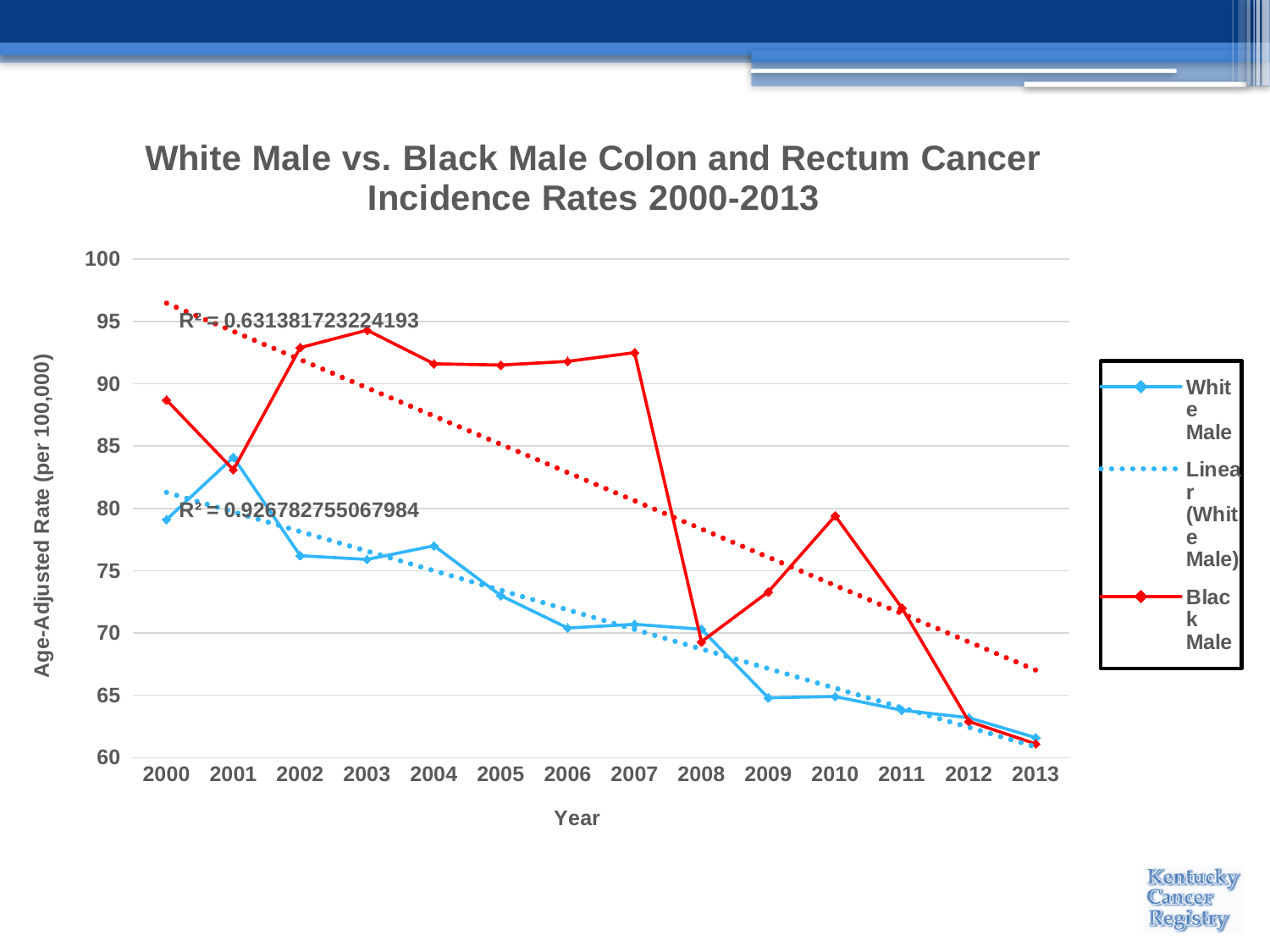
In 2009, which series has the higher value, White Male or Black Male? Black Male What is the title of the y axis? Age-Adjusted Rate (per 100,000) How many years are plotted along the x axis? 14 Is the White Male value for 2013 greater or less than 65? less How many entries does the legend list? 3 What kind of chart is shown on the slide? line chart What is the R² value shown for the White Male linear trendline? 0.926782755067984 In which year is the White Male incidence rate lowest? 2013 Does the White Male incidence rate generally rise or fall from 2000 to 2013? fall Is the Black Male value for 2003 greater or less than 90? greater Is the Black Male value for 2000 greater or less than 85? greater